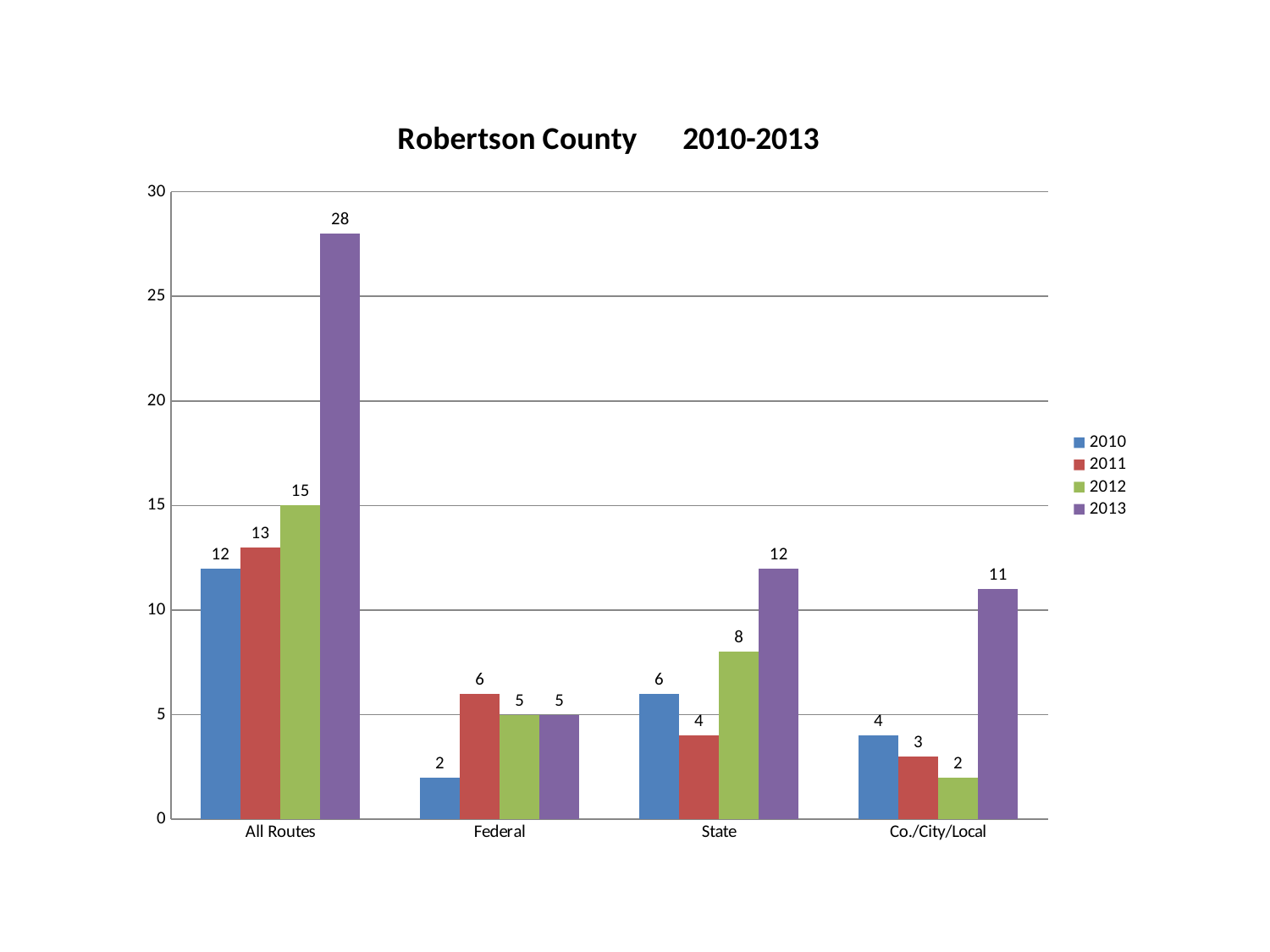
How many categories are shown on the x axis? 4 What is the value for 2013 in the All Routes category? 28 What is the value for 2010 in the Co./City/Local category? 4 Which is larger in the State category, the 2010 value or the 2011 value? 2010 How many series does the legend list? 4 Which category has the highest value for the 2013 series? All Routes What is the title of the chart? Robertson County 2010-2013 What is the value for 2011 in the Federal category? 6 Which category has the lowest value for the 2010 series? Federal What is the value for 2012 in the State category? 8 What kind of chart is shown on the slide? Bar chart What is the difference between the 2013 and 2010 values in the All Routes category? 16